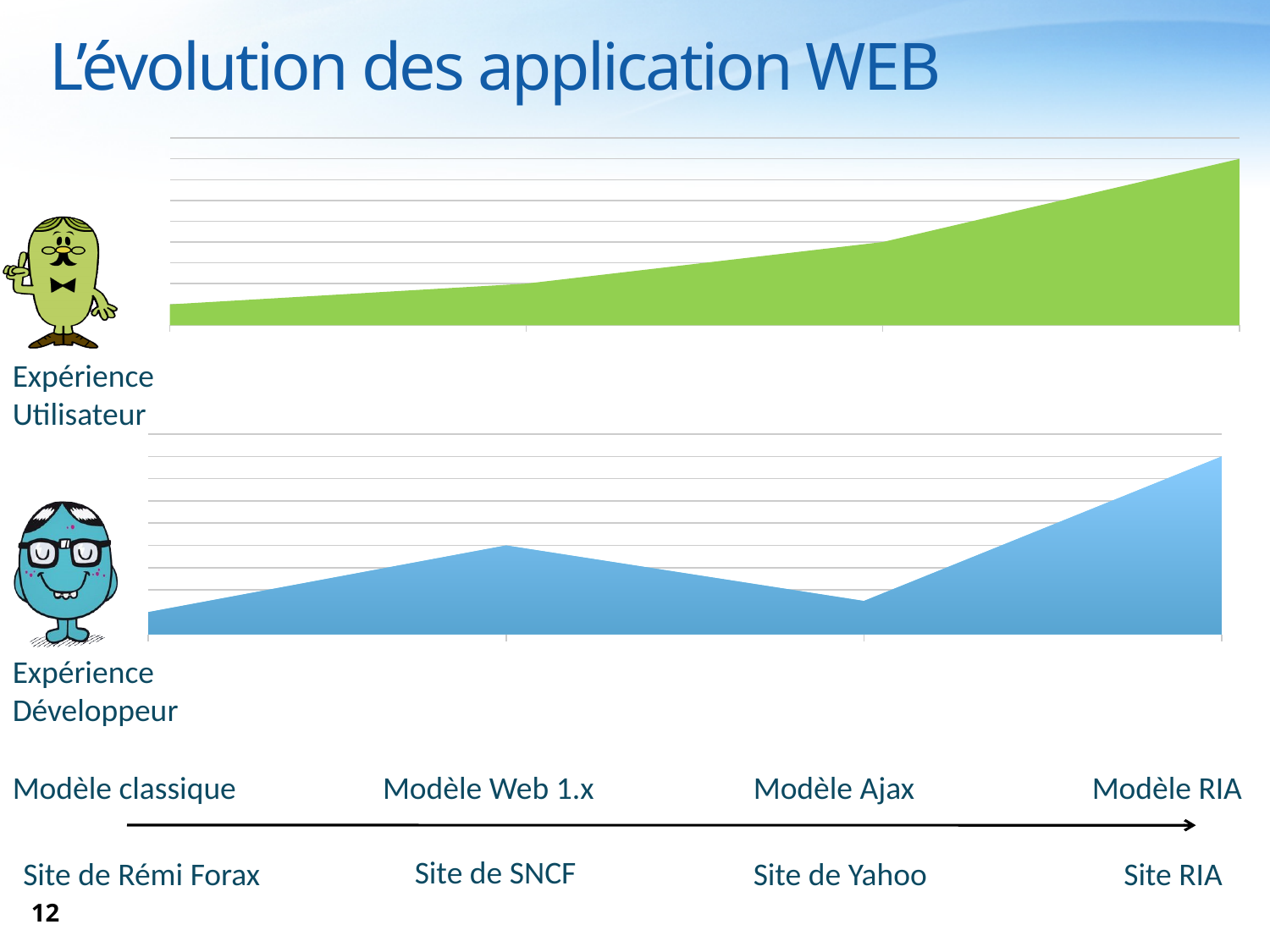
In the bottom chart (Expérience Développeur), does the value rise or fall between Modèle Ajax and Modèle RIA? Rise What kind of chart is the top chart (Expérience Utilisateur)? Area chart What colour is the area in the bottom chart (Expérience Développeur)? Blue What colour is the area in the top chart (Expérience Utilisateur)? Green In the top chart (Expérience Utilisateur), which model has the lowest value? Modèle classique In the bottom chart (Expérience Développeur), does the value rise or fall between Modèle Web 1.x and Modèle Ajax? Fall What kind of chart is the bottom chart (Expérience Développeur)? Area chart In the top chart (Expérience Utilisateur), do the values rise or fall from Modèle classique to Modèle RIA? Rise How many models (points) are plotted along the x axis of each chart? 4 In the bottom chart (Expérience Développeur), which is larger, the value for Modèle Web 1.x or the value for Modèle Ajax? Modèle Web 1.x In the bottom chart (Expérience Développeur), which model has the highest value? Modèle RIA In the top chart (Expérience Utilisateur), which model has the highest value? Modèle RIA